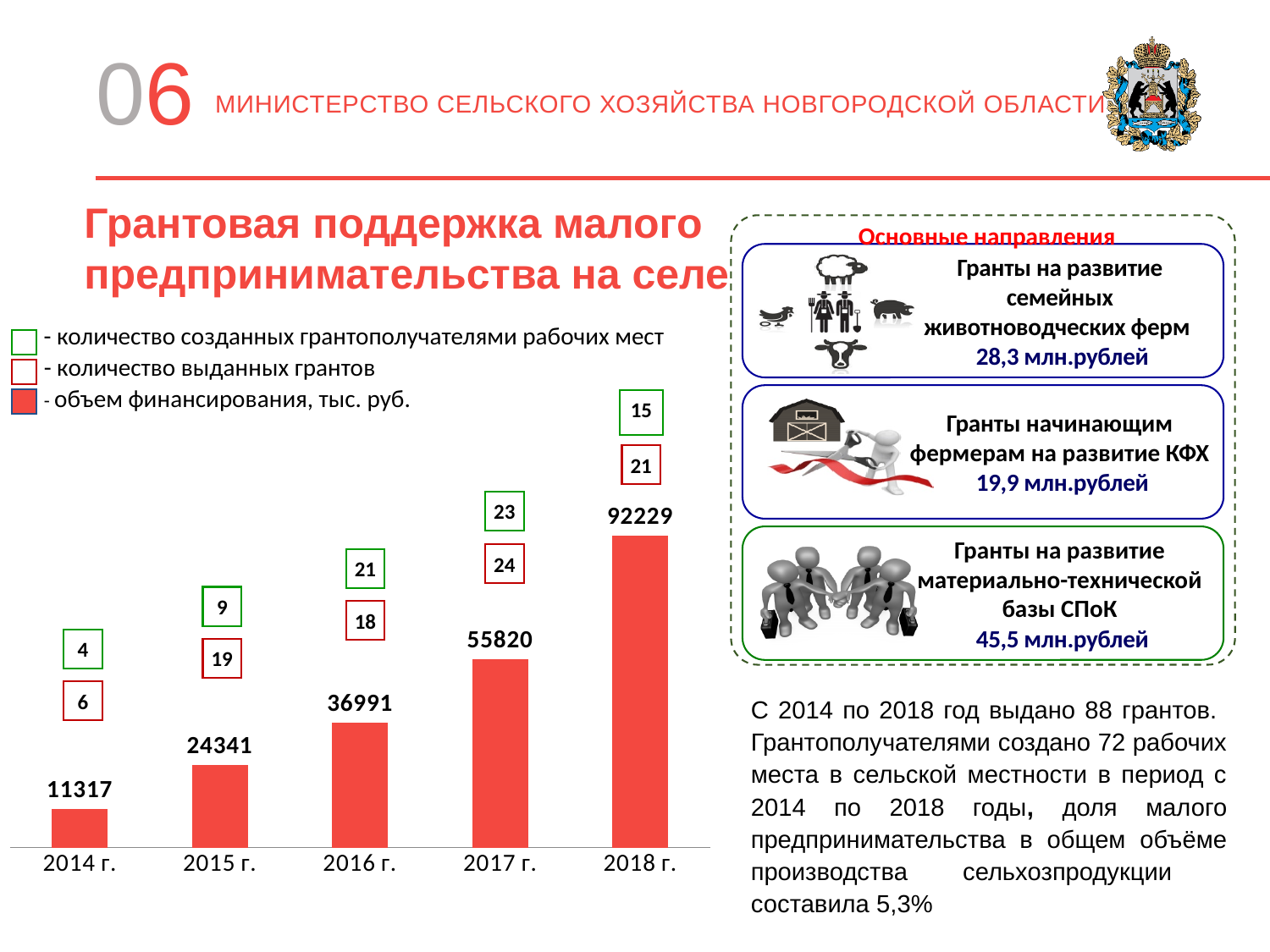
What is the volume of financing (объем финансирования, тыс. руб.) shown for 2018 г.? 92229 How many years (categories) are shown on the x axis of the chart? 5 Does the volume of financing rise or fall from 2014 г. to 2018 г.? rises How many grants (количество выданных грантов) were issued in 2017 г. according to the chart? 24 Which year has the highest volume of financing? 2018 г. Which year has a larger financing volume, 2015 г. or 2016 г.? 2016 г. What is the volume of financing shown for 2014 г.? 11317 Which year has the lowest volume of financing? 2014 г. What kind of chart is used to show the volume of financing? bar chart What is the difference in financing volume between 2018 г. and 2017 г.? 36409 How many series does the legend of the chart list? 3 How many jobs created by grant recipients (количество созданных рабочих мест) are shown for 2016 г.? 21